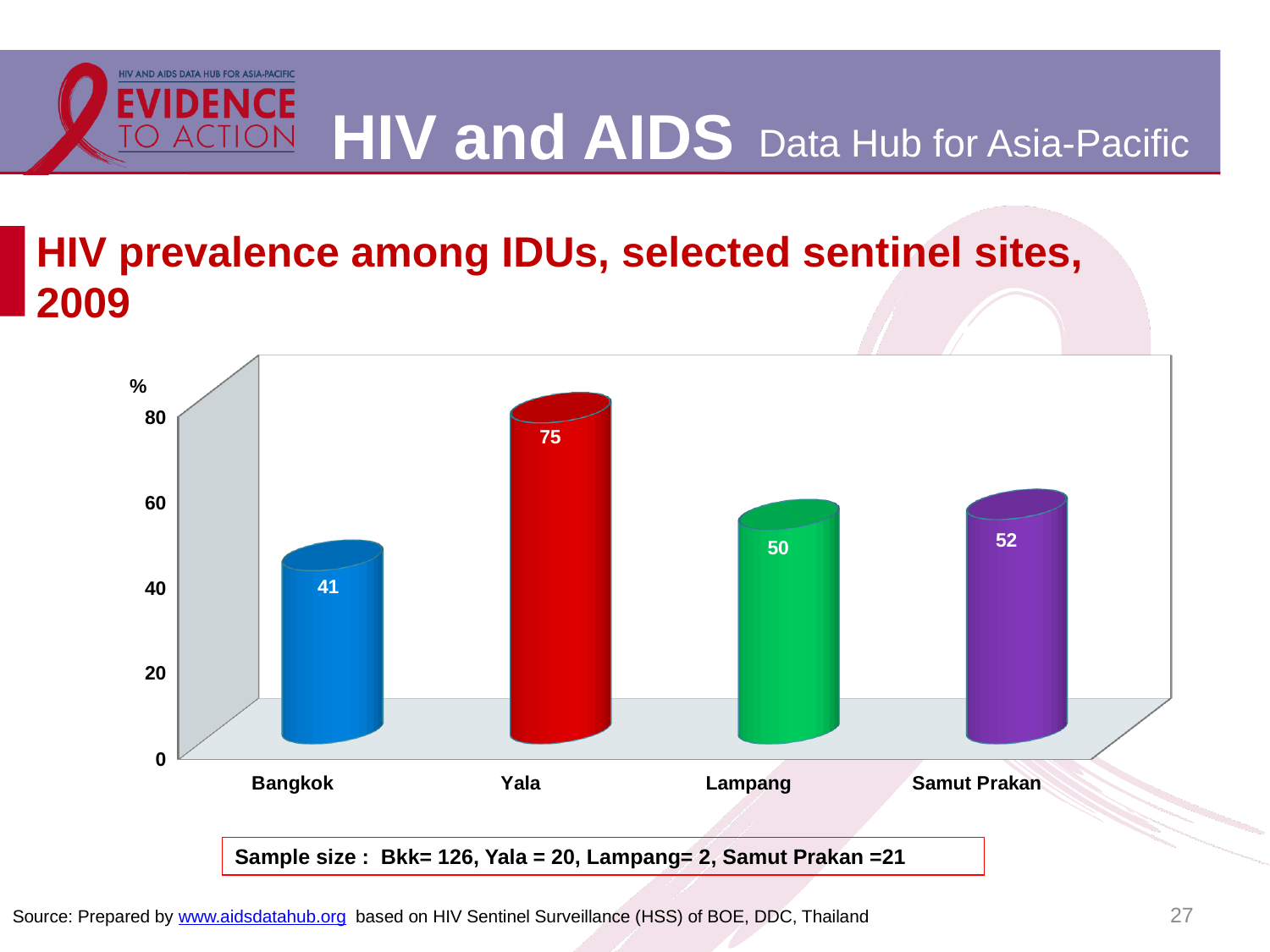
What is the difference between the HIV prevalence values for Samut Prakan and Lampang? 2 What is the HIV prevalence value for Yala? 75 Which sentinel site has the highest HIV prevalence? Yala Which has a higher HIV prevalence, Bangkok or Lampang? Lampang What is the HIV prevalence value for Bangkok? 41 What is the difference between the HIV prevalence values for Yala and Bangkok? 34 What kind of chart is shown on the slide? Bar chart What is the HIV prevalence value for Samut Prakan? 52 What is the HIV prevalence value for Lampang? 50 What unit is shown on the vertical axis of the chart? % Which sentinel site has the lowest HIV prevalence? Bangkok How many sentinel sites are shown in the chart? 4